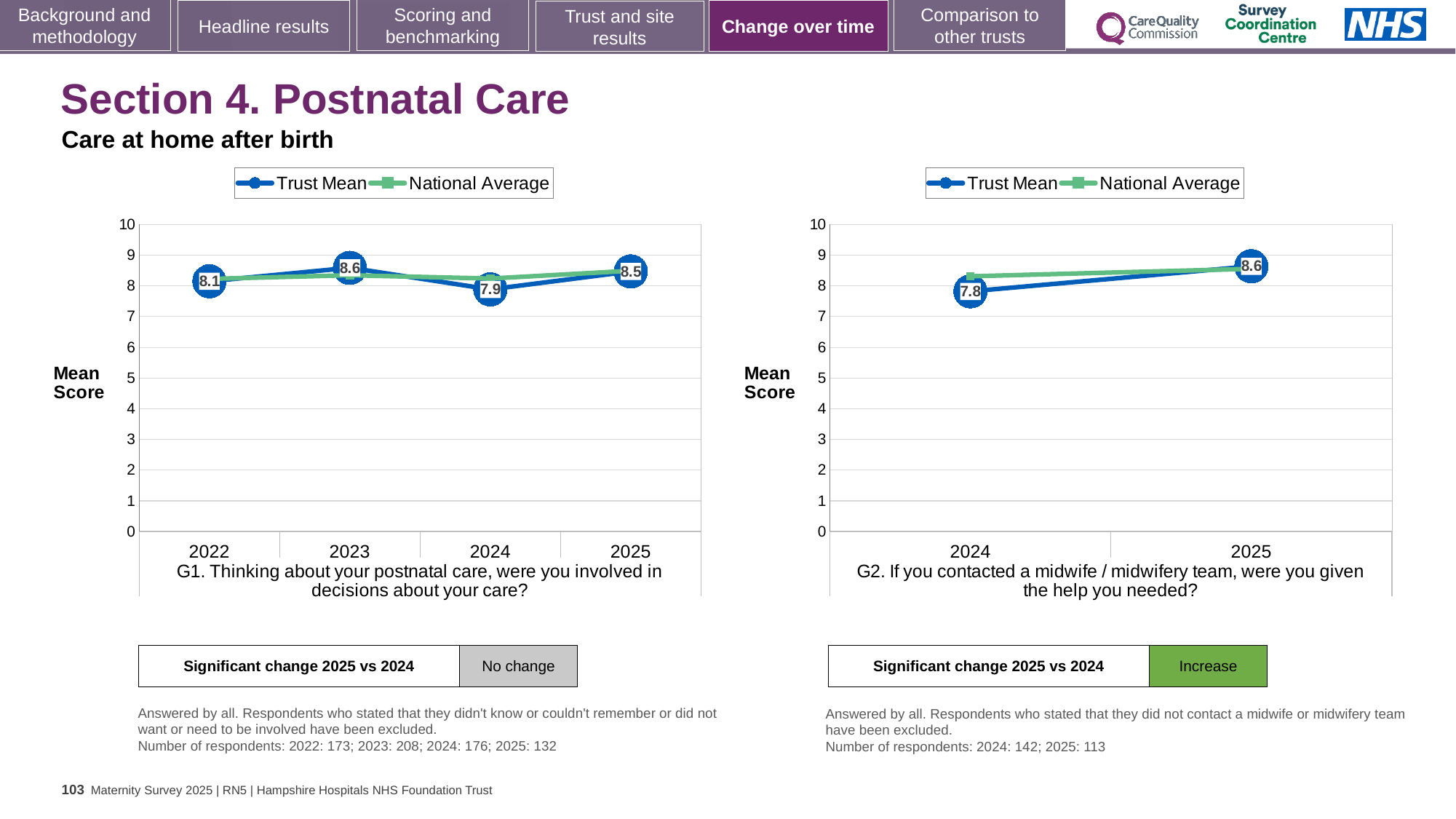
In the G2 chart on the right, does the Trust Mean rise or fall from 2024 to 2025? Rise In the G1 chart on the left, which year has the lowest Trust Mean? 2024 In the G1 chart on the left, is the Trust Mean higher in 2023 or in 2025? 2023 In the G2 chart on the right, is the National Average for 2024 greater or less than 7? greater What kind of chart is the G1 chart on the left? Line chart In the G1 chart on the left, what is the Trust Mean for 2022? 8.1 In the G2 chart on the right, what is the Trust Mean for 2025? 8.6 In the G1 chart on the left, which year has the highest Trust Mean? 2023 How many series does the legend of the G2 chart on the right list? 2 How many years are plotted on the x axis of the G1 chart on the left? 4 In the G1 chart on the left, what is the Trust Mean for 2024? 7.9 In the G2 chart on the right, what is the difference between the Trust Mean for 2025 and 2024? 0.8